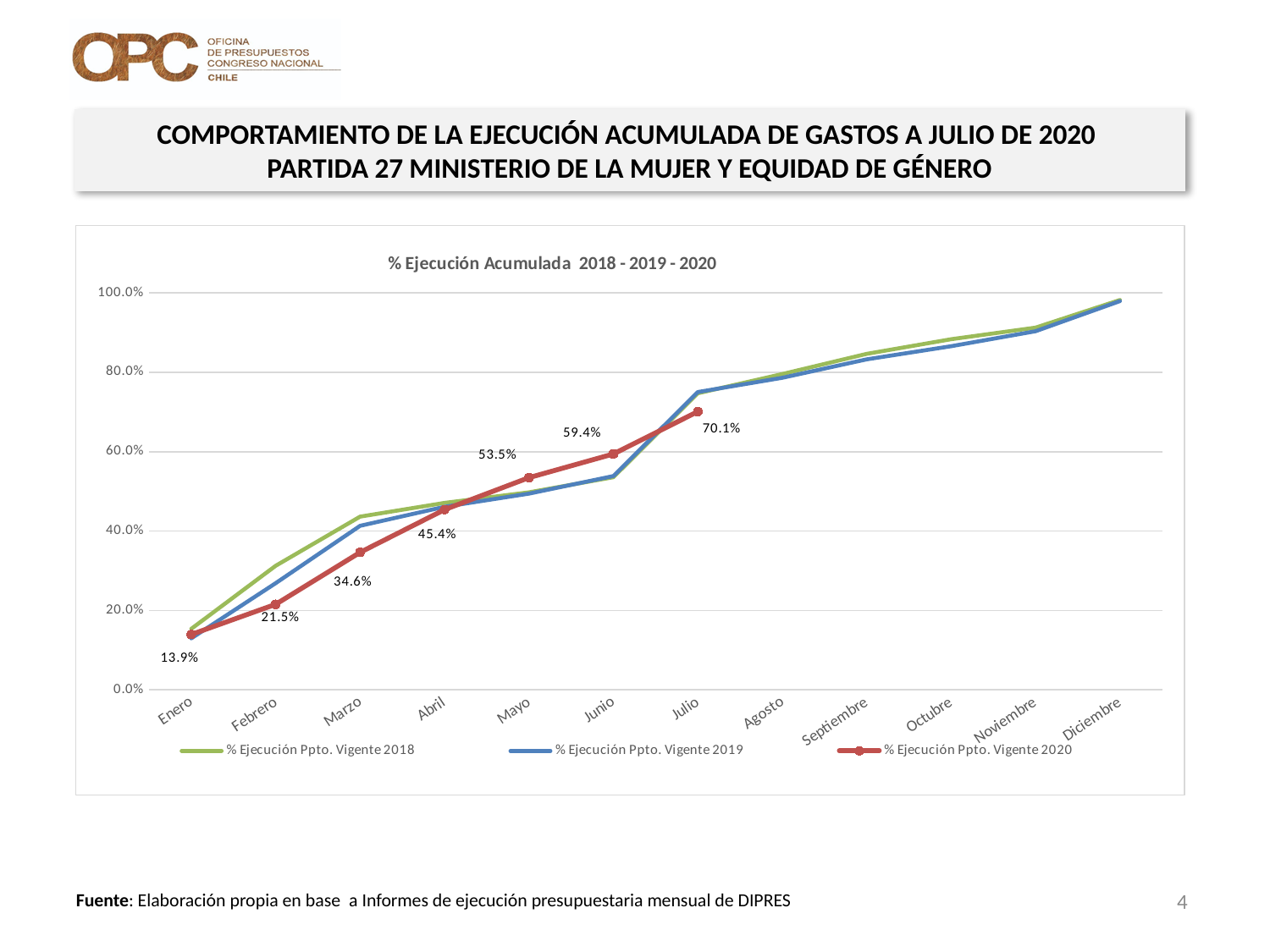
What is the chart's title? % Ejecución Acumulada 2018 - 2019 - 2020 What is the value for Abril in the % Ejecución Ppto. Vigente 2020 series? 45.4% Does the % Ejecución Ppto. Vigente 2020 series rise or fall from Enero to Julio? rise What is the value for Julio in the % Ejecución Ppto. Vigente 2020 series? 70.1% What is the difference between the Marzo and Febrero values in the % Ejecución Ppto. Vigente 2020 series? 13.1% How many series does the legend list? 3 In Marzo, which series has the larger value: % Ejecución Ppto. Vigente 2018 or % Ejecución Ppto. Vigente 2020? % Ejecución Ppto. Vigente 2018 Is the value for Diciembre in the % Ejecución Ppto. Vigente 2019 series greater or less than 80.0%? greater What is the difference between the Julio and Junio values in the % Ejecución Ppto. Vigente 2020 series? 10.7% What is the value for Enero in the % Ejecución Ppto. Vigente 2020 series? 13.9% How many months are shown on the x axis? 12 What kind of chart is shown on the slide? line chart